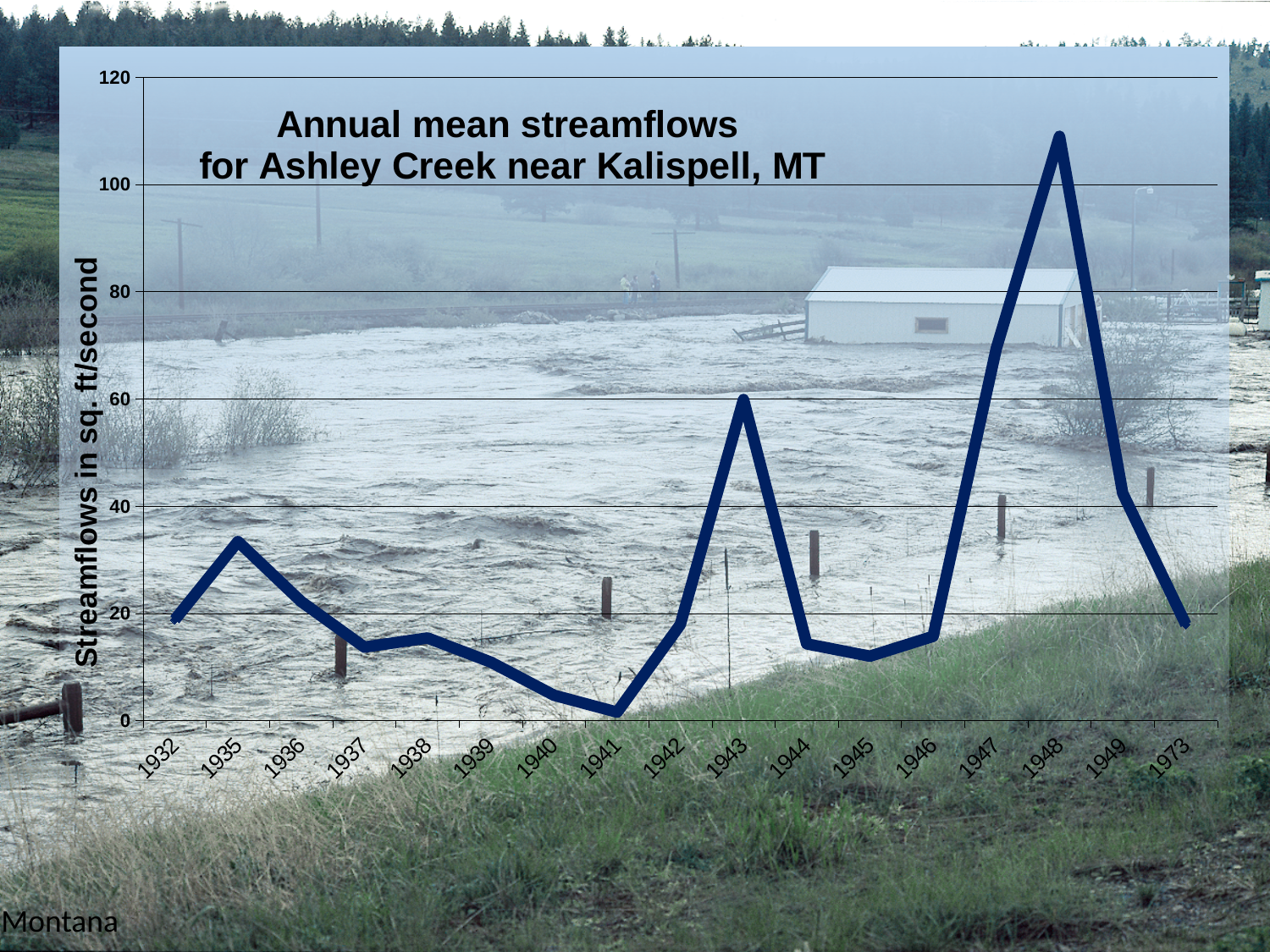
Do the streamflow values rise or fall from 1935 to 1941? fall How many years are plotted along the x axis of the chart? 17 What kind of chart is shown on the slide? line chart Is the value for 1948 greater or less than 100? greater Which year has the highest annual mean streamflow on the chart? 1948 Which year has the larger streamflow, 1943 or 1948? 1948 What is the title of the chart? Annual mean streamflows for Ashley Creek near Kalispell, MT Is the value for 1935 greater or less than 20? greater Is the value for 1941 greater or less than 20? less Which year has the lowest annual mean streamflow on the chart? 1941 What is the label on the vertical axis of the chart? Streamflows in sq. ft/second Which year has the larger streamflow, 1935 or 1937? 1935